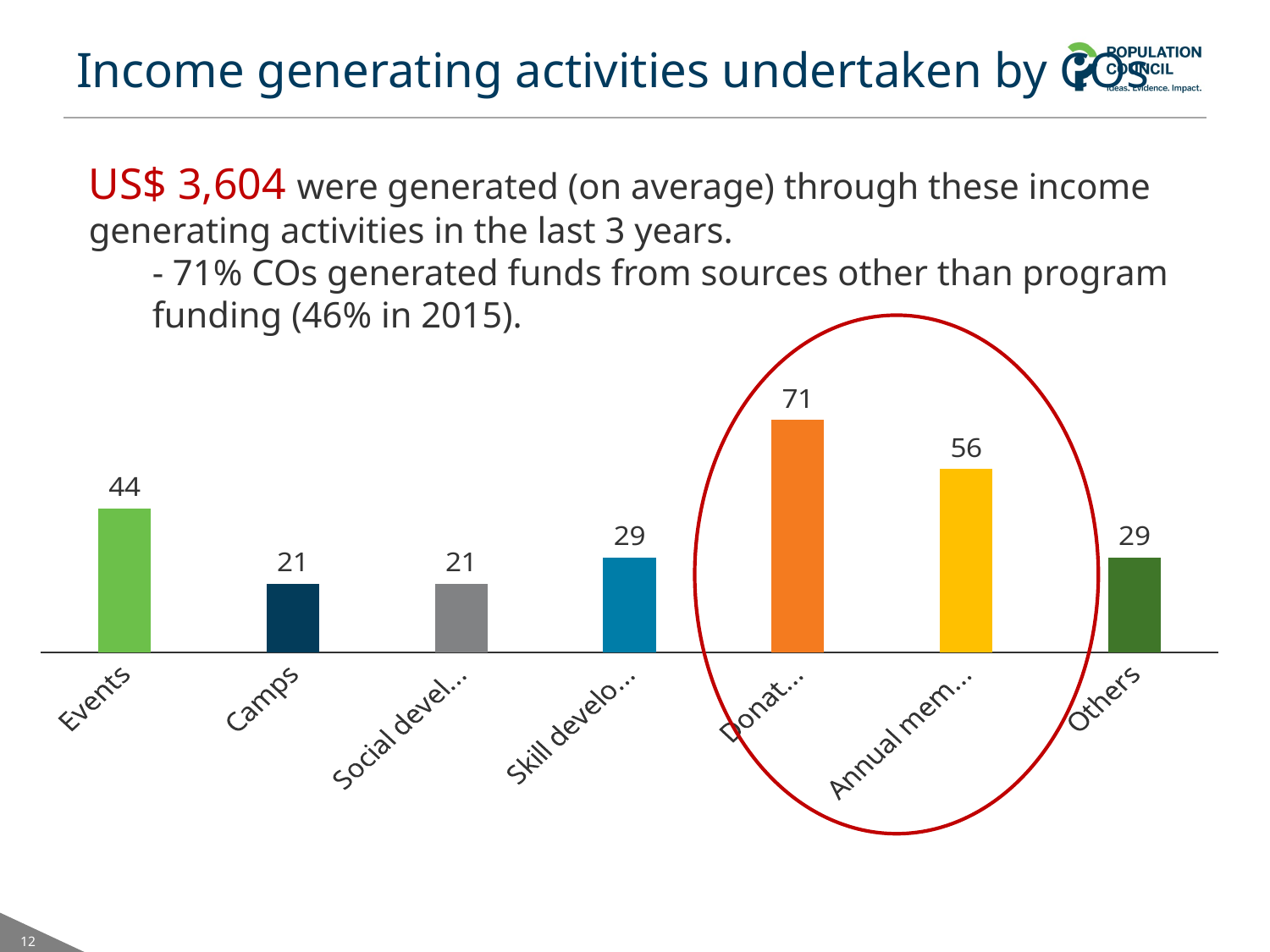
What is the value for Others? 29 Which has a larger value, Events or Others? Events What is the difference between the values for Events and Camps? 23 What is the difference between the value for the bar labelled "Donat…" and the bar labelled "Annual mem…"? 15 What is the value for Camps? 21 What is the value for the bar labelled "Annual mem…"? 56 What is the lowest value shown in the chart? 21 How many categories are shown in the chart? 7 What is the highest value shown in the chart? 71 How many bars are enclosed by the red circle on the chart? 2 What kind of chart is shown on the slide? Bar chart What is the value for Events? 44